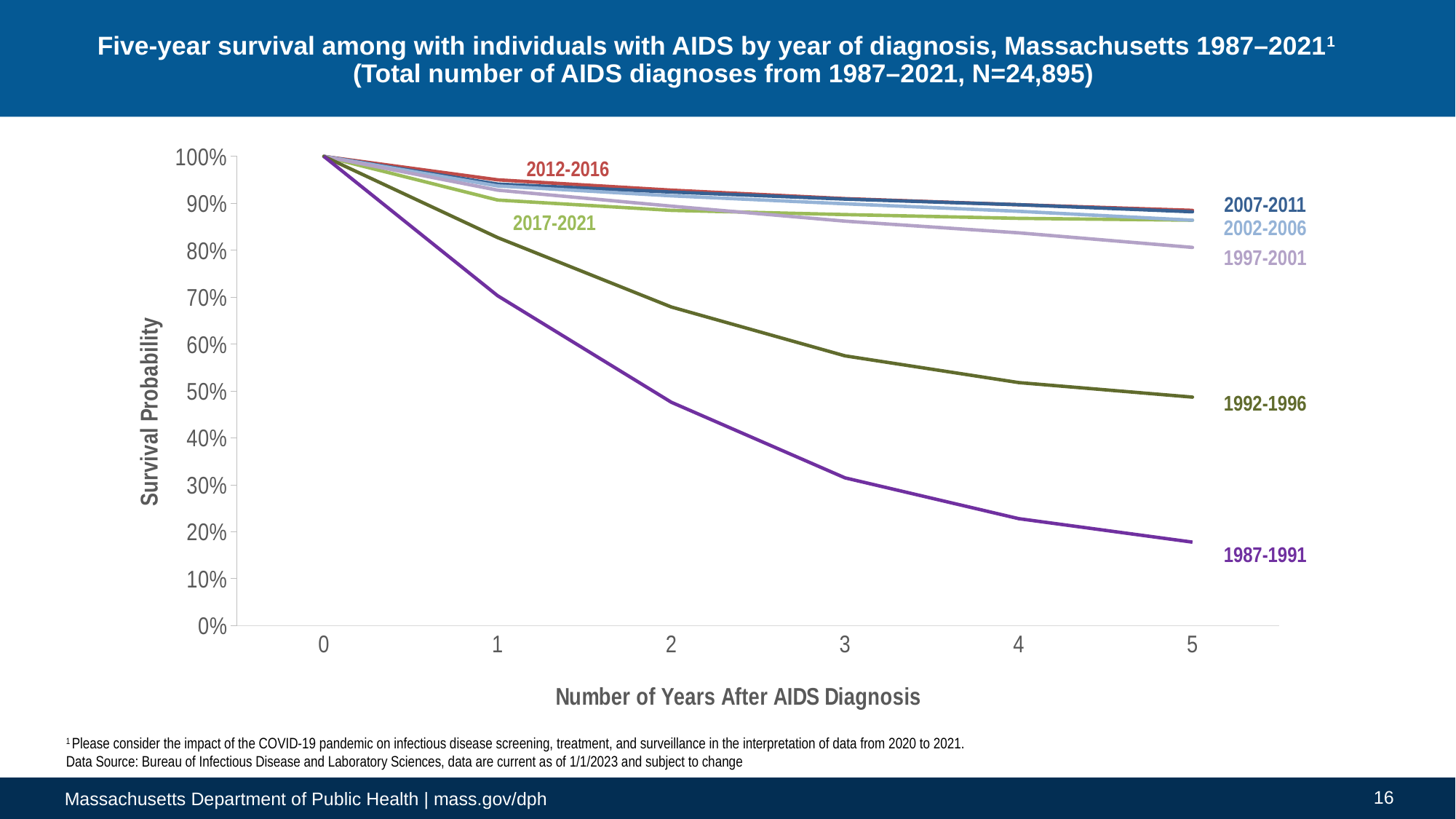
How many diagnosis-period series are plotted on the chart? 7 Is the survival probability for the 2007-2011 series at 5 years greater or less than 80%? greater Do the survival probability lines rise or fall as the number of years after diagnosis increases? Fall Is the survival probability for the 1987-1991 series at 5 years greater or less than 20%? less Which diagnosis period has the lowest survival probability at 5 years after diagnosis? 1987-1991 At 3 years after diagnosis, which series has the higher survival probability: 1992-1996 or 1987-1991? 1992-1996 What is the label of the y axis? Survival Probability Is the survival probability for the 1992-1996 series at 5 years greater or less than 60%? less How many points are marked on the x axis (Number of Years After AIDS Diagnosis)? 6 What kind of chart is shown on the slide? Line chart What is the survival probability for the 1987-1991 series at 0 years after diagnosis? 100%